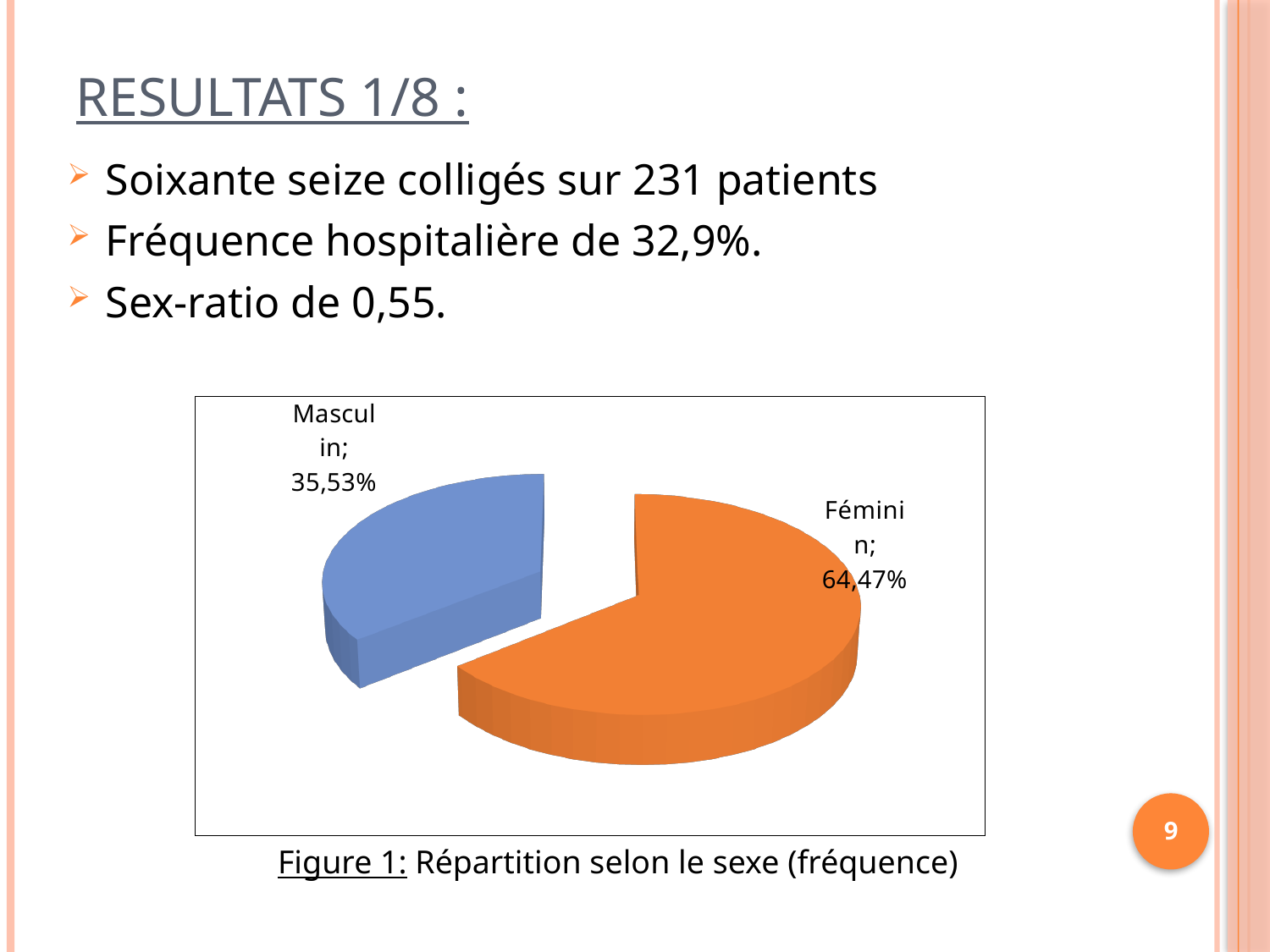
What is the caption of the figure below the pie chart? Figure 1: Répartition selon le sexe (fréquence) Which category has the smallest slice in the pie chart? Masculin What colour is the Masculin slice in the pie chart? Blue What share of the pie does the Féminin slice represent? 64,47% What percentage of the pie chart is labelled Masculin? 35,53% Which category has the largest slice in the pie chart? Féminin How many slices does the pie chart have? 2 Which slice is larger, Masculin or Féminin? Féminin What kind of chart is shown on the slide? Pie chart What is the difference in percentage points between the Féminin and Masculin slices? 28,94 What percentage of the pie chart is labelled Féminin? 64,47%